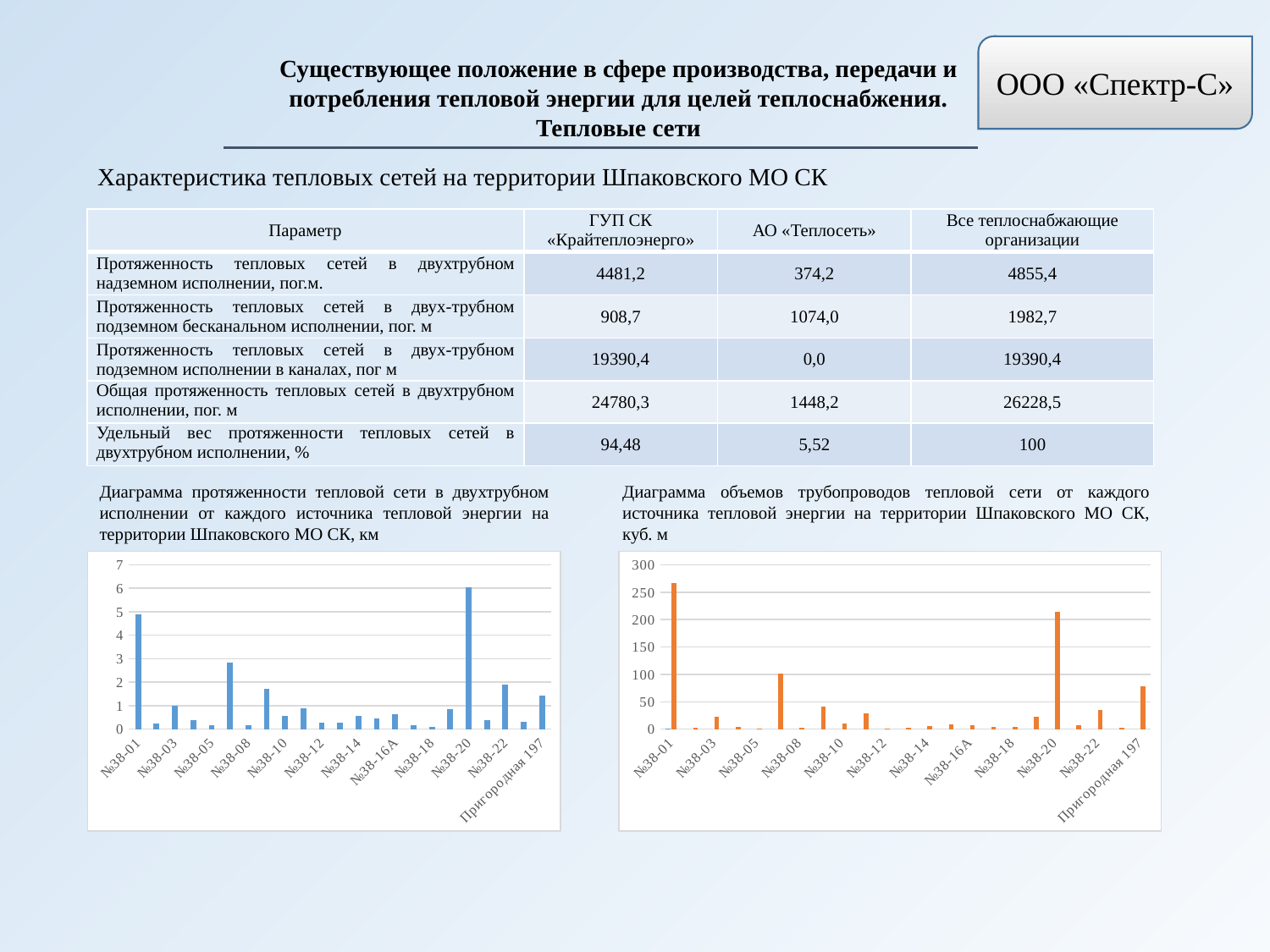
In the left chart (lengths of heat network, km), which is larger, the value for №38-01 or for №38-20? №38-20 In the left chart (lengths of heat network, km), which category has the highest bar? №38-20 In the left chart (lengths of heat network, km), is the value for №38-01 greater or less than 4? greater In the left chart (lengths of heat network, km), is the value for №38-20 greater or less than 5? greater In the right chart (pipeline volumes, куб. м), which category has the highest bar? №38-01 In the right chart (pipeline volumes, куб. м), is the value for №38-01 greater or less than 250? greater In the right chart (pipeline volumes, куб. м), which is larger, the value for №38-01 or for №38-20? №38-01 What colour are the bars in the right chart (pipeline volumes, куб. м)? orange What kind of chart is the left chart (lengths of heat network, km)? bar chart